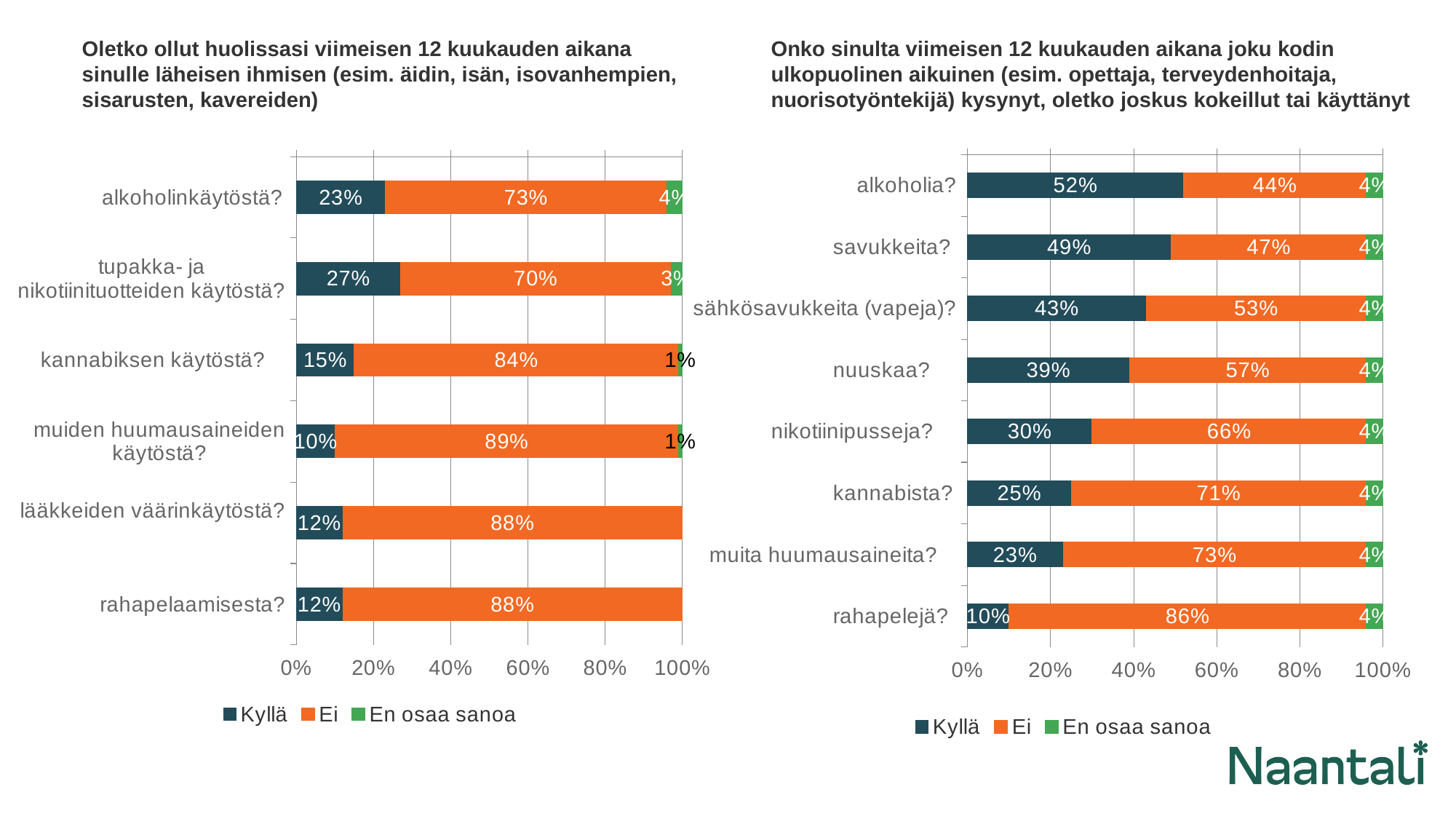
In the left chart (Oletko ollut huolissasi...), how many categories are shown? 6 In the left chart (Oletko ollut huolissasi...), what is the Ei value for kannabiksen käytöstä? 84% In the right chart (Onko sinulta...), how many categories are shown? 8 In the right chart (Onko sinulta...), what is the difference between the Ei values for rahapelejä and alkoholia? 42% In the left chart (Oletko ollut huolissasi...), which category has the highest Kyllä value? tupakka- ja nikotiinituotteiden käytöstä In the right chart (Onko sinulta...), which category has the lowest Kyllä value? rahapelejä In the left chart (Oletko ollut huolissasi...), what is the difference between the Ei values for alkoholinkäytöstä and tupakka- ja nikotiinituotteiden käytöstä? 3% What type of chart is the left chart (Oletko ollut huolissasi...)? Stacked bar chart In the left chart (Oletko ollut huolissasi viimeisen 12 kuukauden aikana...), what is the Kyllä value for alkoholinkäytöstä? 23% How many series does the legend of the right chart (Onko sinulta...) list? 3 In the right chart (Onko sinulta...), which is larger: the Kyllä value for alkoholia or for savukkeita? alkoholia In the right chart (Onko sinulta viimeisen 12 kuukauden aikana joku kodin ulkopuolinen aikuinen...), what is the Kyllä value for nuuskaa? 39%